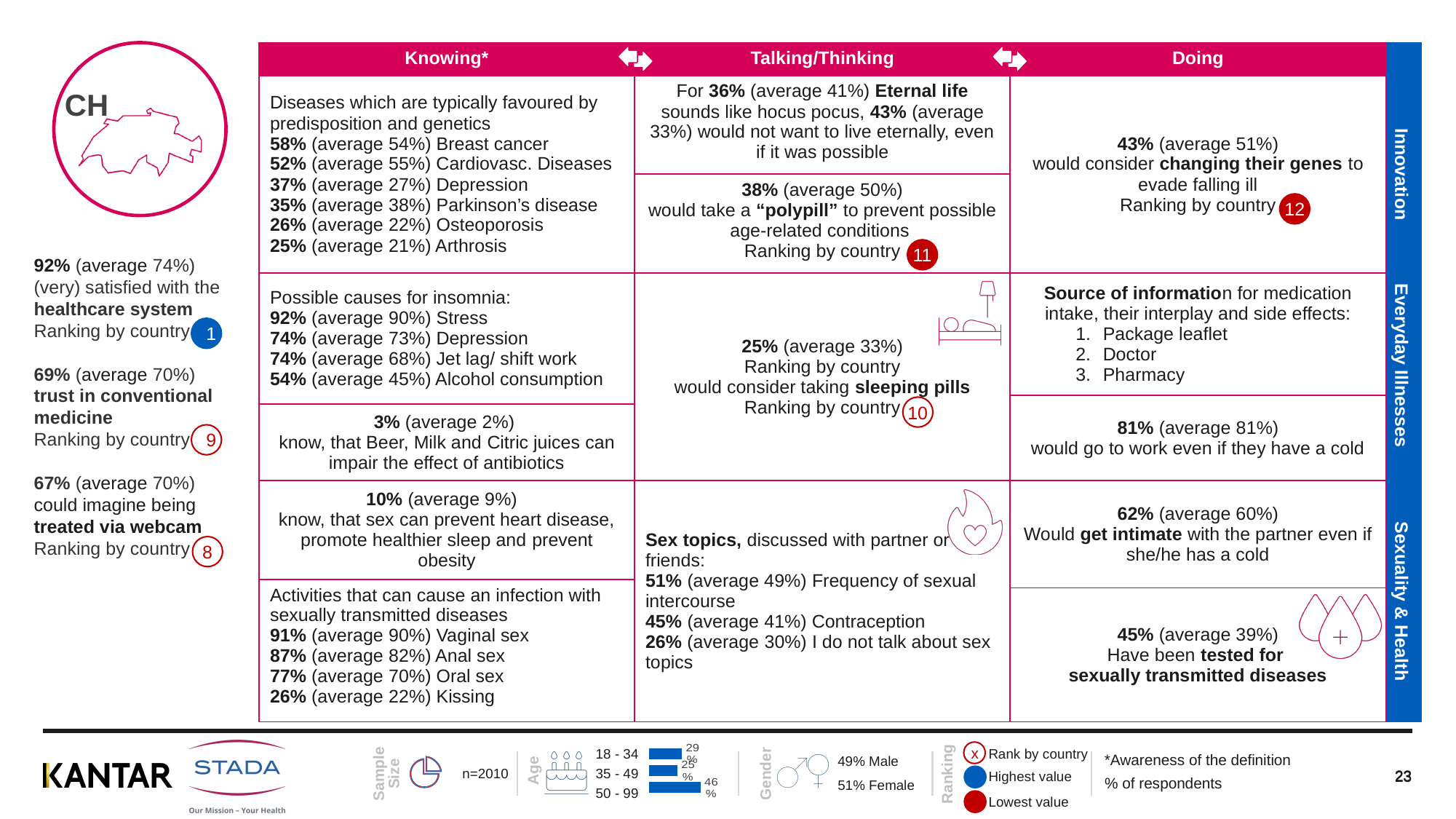
In the age bar chart at the bottom of the slide, what is the difference between the 18 - 34 group and the 35 - 49 group? 4% In the age bar chart at the bottom of the slide, which age group has the lowest value? 35 - 49 In the age bar chart at the bottom of the slide, what is the difference between the 50 - 99 group and the 18 - 34 group? 17% In the age bar chart at the bottom of the slide, which age group has the highest value? 50 - 99 In the age bar chart at the bottom of the slide, which is larger: the value for 18 - 34 or the value for 35 - 49? 18 - 34 In the age bar chart at the bottom of the slide, what is the value for the 18 - 34 group? 29% How many age groups are shown in the age bar chart at the bottom of the slide? 3 What does the bar chart at the bottom of the slide show? Age distribution of the sample In the age bar chart at the bottom of the slide, what is the difference between the 50 - 99 group and the 35 - 49 group? 21% In the age bar chart at the bottom of the slide, what is the value for the 35 - 49 group? 25% What kind of chart is the age chart at the bottom of the slide? bar chart In the age bar chart at the bottom of the slide, what is the value for the 50 - 99 group? 46%